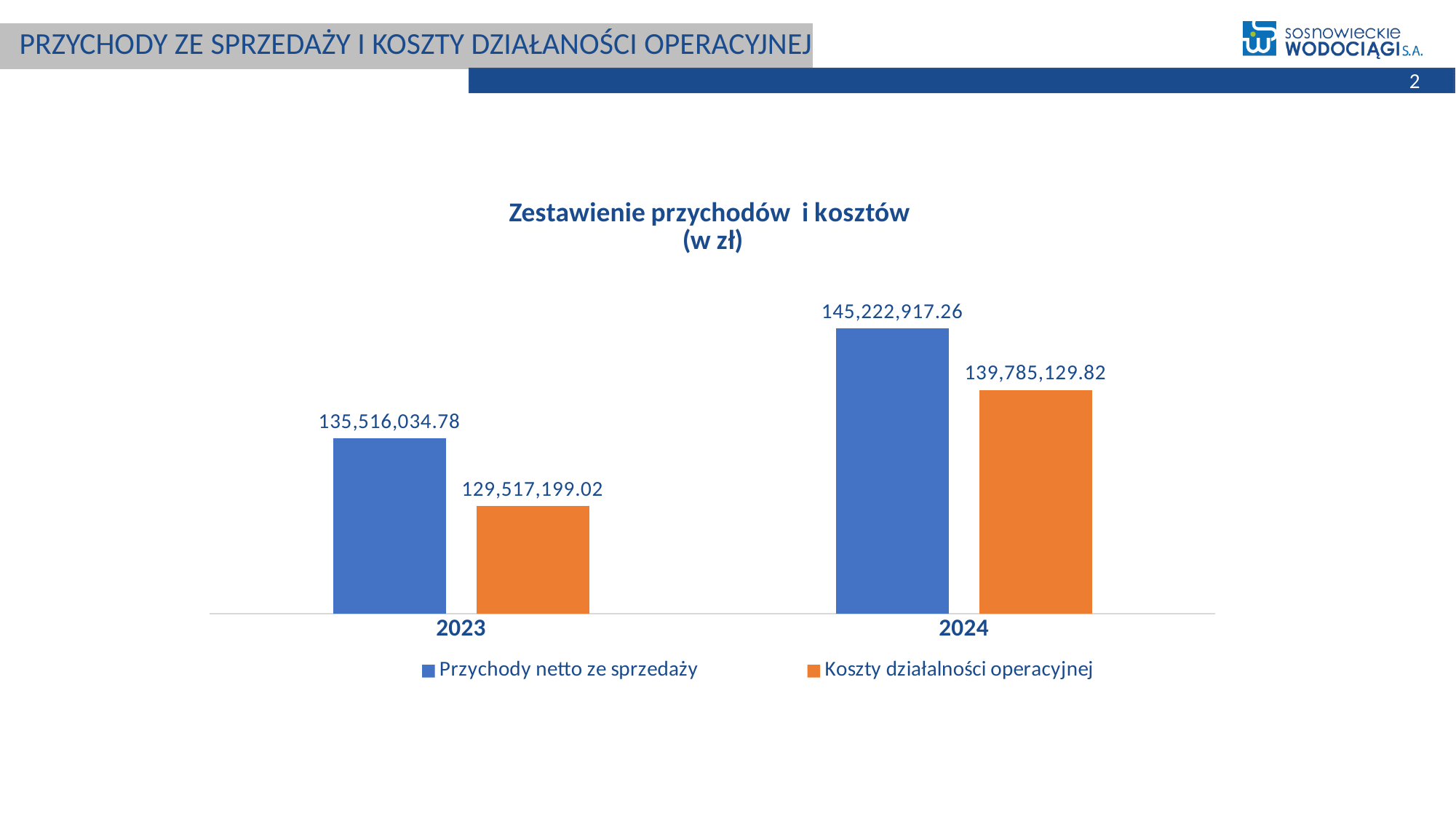
How many series does the legend list? 2 What is the value of Przychody netto ze sprzedaży for 2024? 145,222,917.26 Do the values of Koszty działalności operacyjnej rise or fall from 2023 to 2024? Rise By how much did Przychody netto ze sprzedaży increase from 2023 to 2024? 9,706,882.48 What kind of chart is shown on the slide? Bar chart What is the difference between Przychody netto ze sprzedaży and Koszty działalności operacyjnej in 2023? 5,998,835.76 Which bar has the lowest value on the chart? Koszty działalności operacyjnej, 2023 What is the value of Koszty działalności operacyjnej for 2023? 129,517,199.02 Which bar has the highest value on the chart? Przychody netto ze sprzedaży, 2024 Which is larger in 2024: Przychody netto ze sprzedaży or Koszty działalności operacyjnej? Przychody netto ze sprzedaży What is the value of Przychody netto ze sprzedaży for 2023? 135,516,034.78 What is the value of Koszty działalności operacyjnej for 2024? 139,785,129.82